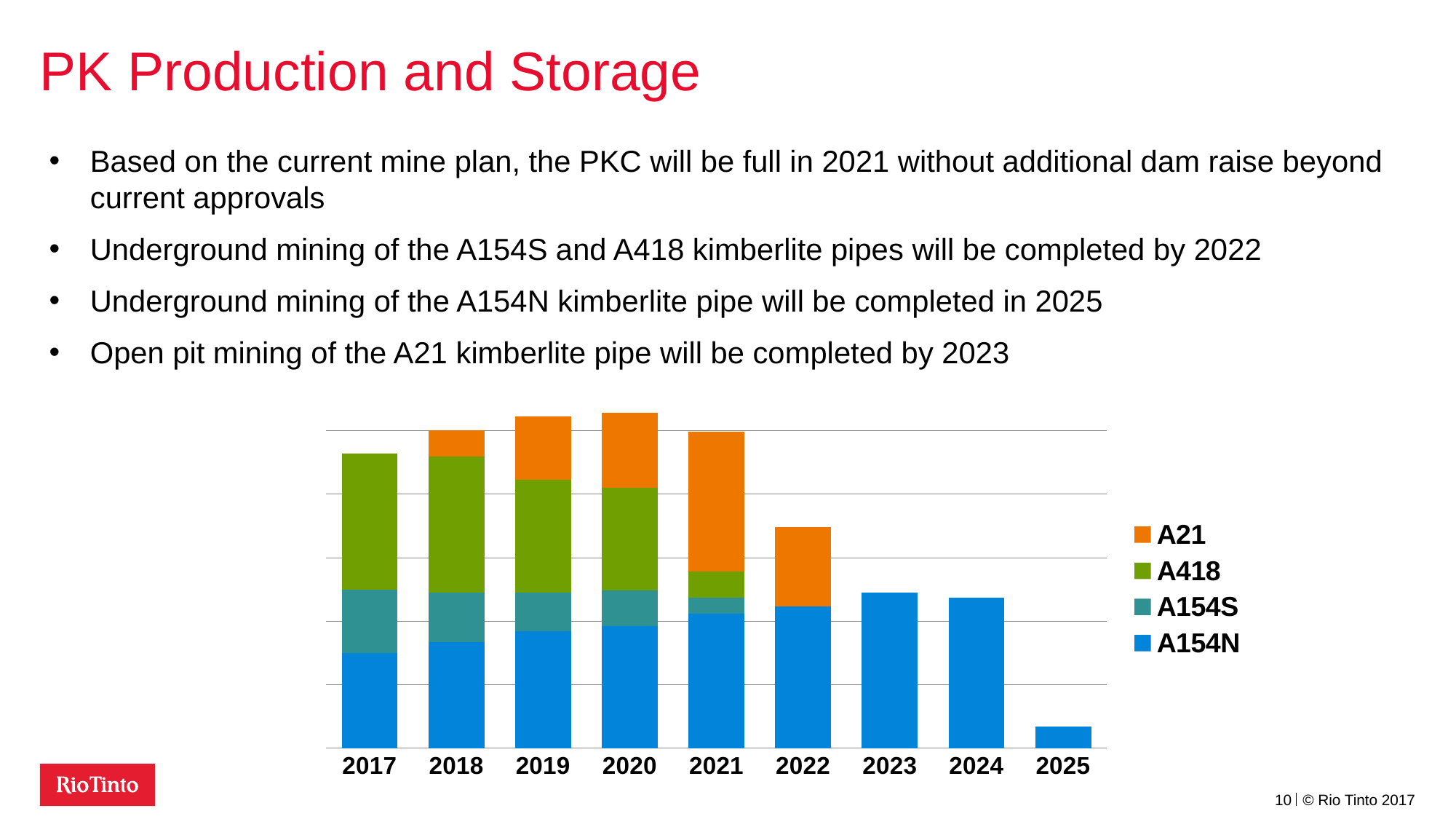
Is the total bar for 2017 larger or smaller than the total bar for 2025? larger Which year has the lowest total bar in the chart? 2025 Which is the only series plotted for 2023, 2024 and 2025? A154N How many series does the chart legend list? 4 Is the A21 segment larger in 2021 or in 2018? 2021 Which is the last year in which the A21 series appears in the chart? 2022 How many years are shown on the x axis of the chart? 9 Which is the first year in which the A21 series appears in the chart? 2018 Which is the last year in which the A418 series appears in the chart? 2021 Do the total bar heights rise or fall from 2020 to 2025? fall What kind of chart is shown on the slide? Stacked bar chart Which series are listed in the chart legend? A21, A418, A154S, A154N